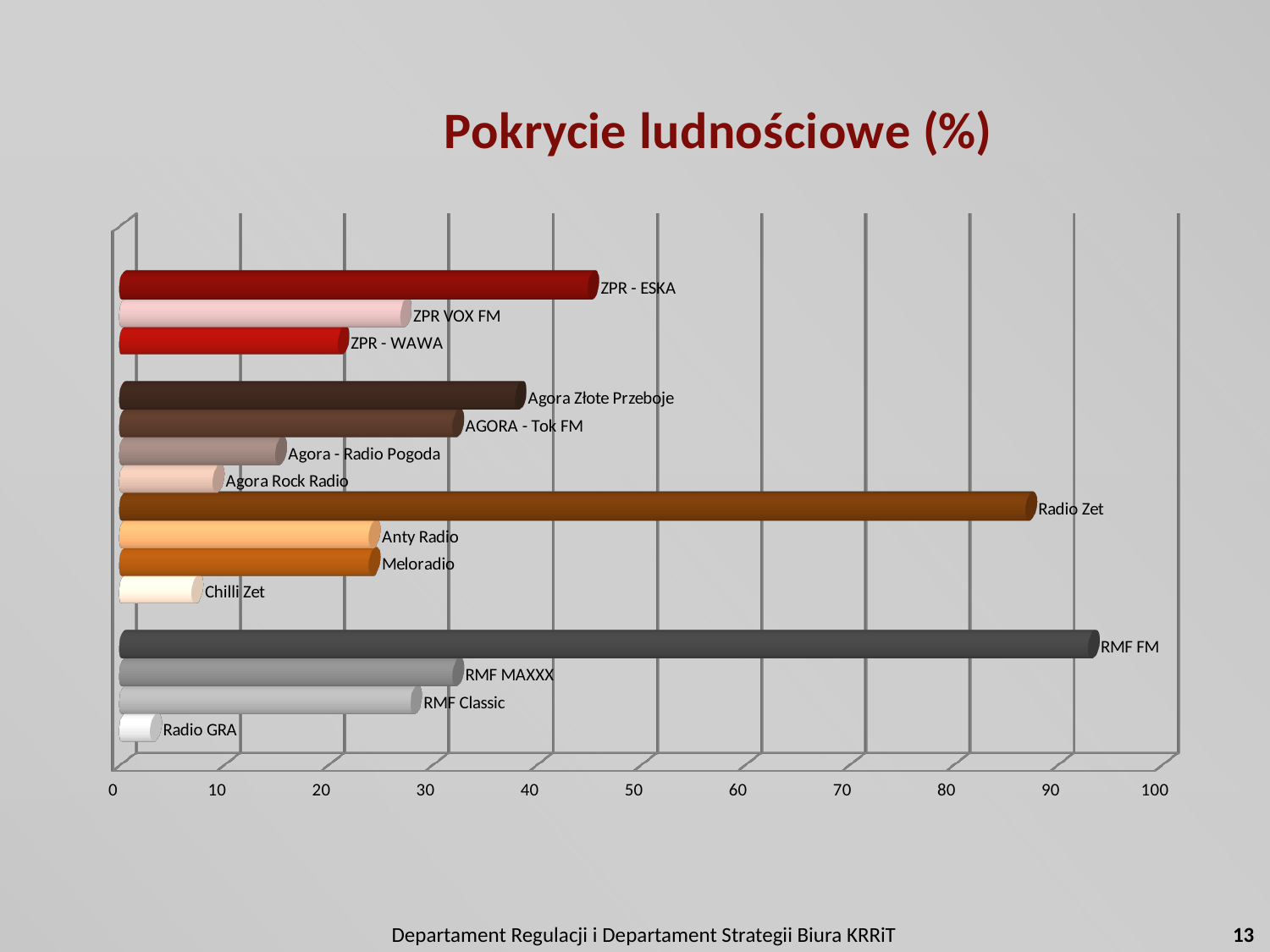
Which radio station has the highest population coverage? RMF FM How many radio stations are plotted in the chart? 15 Is the value for ZPR - WAWA greater or less than 30? less Is the value for ZPR - ESKA greater or less than 40? greater Which has a larger value, Agora Rock Radio or Agora - Radio Pogoda? Agora - Radio Pogoda Is the value for Chilli Zet greater or less than 10? less Which radio station has the lowest population coverage? Radio GRA What is the title of the chart? Pokrycie ludnościowe (%) What kind of chart is shown on the slide? bar chart Which has a larger value, Radio Zet or RMF FM? RMF FM